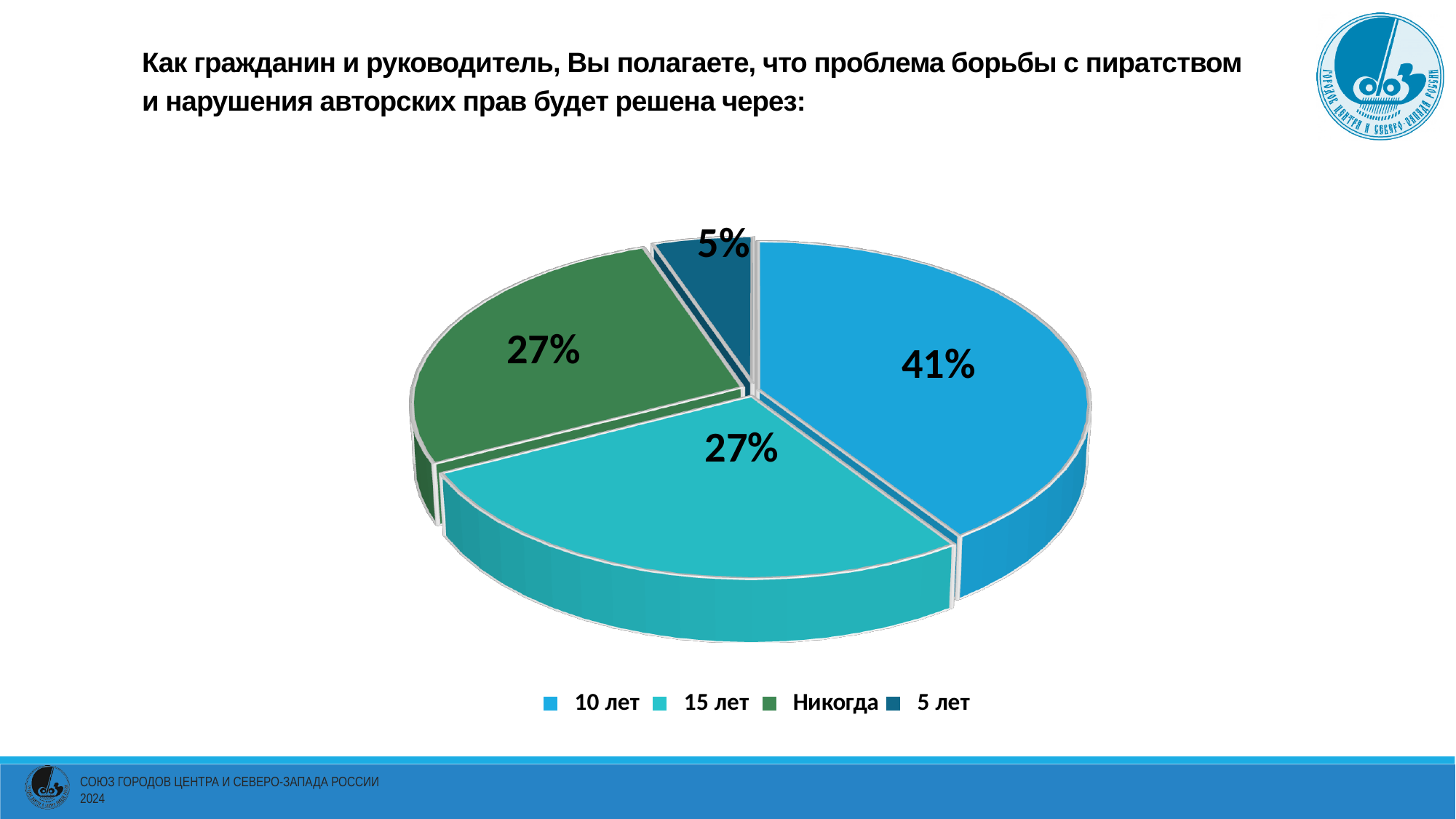
What is the difference in percentage points between the "10 лет" slice and the "Никогда" slice? 14 What share of the pie does the "Никогда" slice represent? 27% What share of the pie does the "5 лет" slice represent? 5% Which category has the largest slice of the pie? 10 лет What kind of chart is shown on the slide? pie chart Which category has the smallest slice of the pie? 5 лет What share of the pie does the "10 лет" slice represent? 41% How many categories does the pie chart have? 4 Which is larger, the "15 лет" slice or the "5 лет" slice? 15 лет How many entries does the legend list? 4 What is the difference in percentage points between the "10 лет" slice and the "5 лет" slice? 36